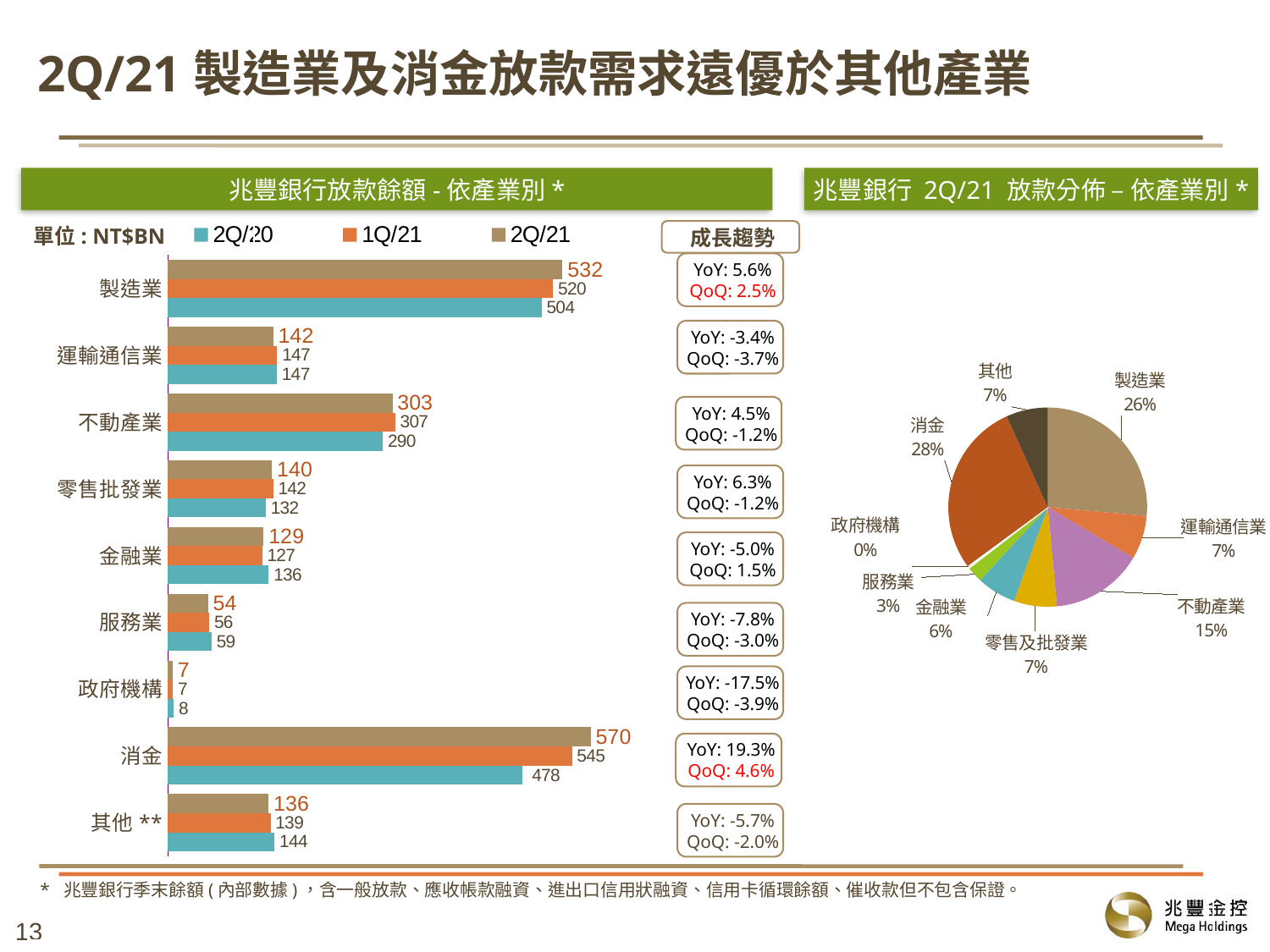
In the bar chart 兆豐銀行放款餘額 - 依產業別, how many series does the legend list? 3 In the bar chart 兆豐銀行放款餘額 - 依產業別, which is larger for 金融業: the 2Q/20 value or the 2Q/21 value? 2Q/20 In the bar chart 兆豐銀行放款餘額 - 依產業別, which category has the highest 2Q/21 value? 消金 In the bar chart 兆豐銀行放款餘額 - 依產業別, how many industry categories are shown? 9 In the pie chart 兆豐銀行 2Q/21 放款分佈 – 依產業別, what share does 不動產業 have? 15% In the bar chart 兆豐銀行放款餘額 - 依產業別, what is the 2Q/21 value for 製造業? 532 What type of chart is 兆豐銀行 2Q/21 放款分佈 – 依產業別? Pie chart In the bar chart 兆豐銀行放款餘額 - 依產業別, which category has the lowest 2Q/21 value? 政府機構 In the pie chart 兆豐銀行 2Q/21 放款分佈 – 依產業別, what share does 消金 have? 28% In the bar chart 兆豐銀行放款餘額 - 依產業別, what is the 1Q/21 value for 不動產業? 307 In the bar chart 兆豐銀行放款餘額 - 依產業別, what is the difference between the 2Q/21 and 2Q/20 values for 消金? 92 In the bar chart 兆豐銀行放款餘額 - 依產業別, what is the 2Q/20 value for 消金? 478